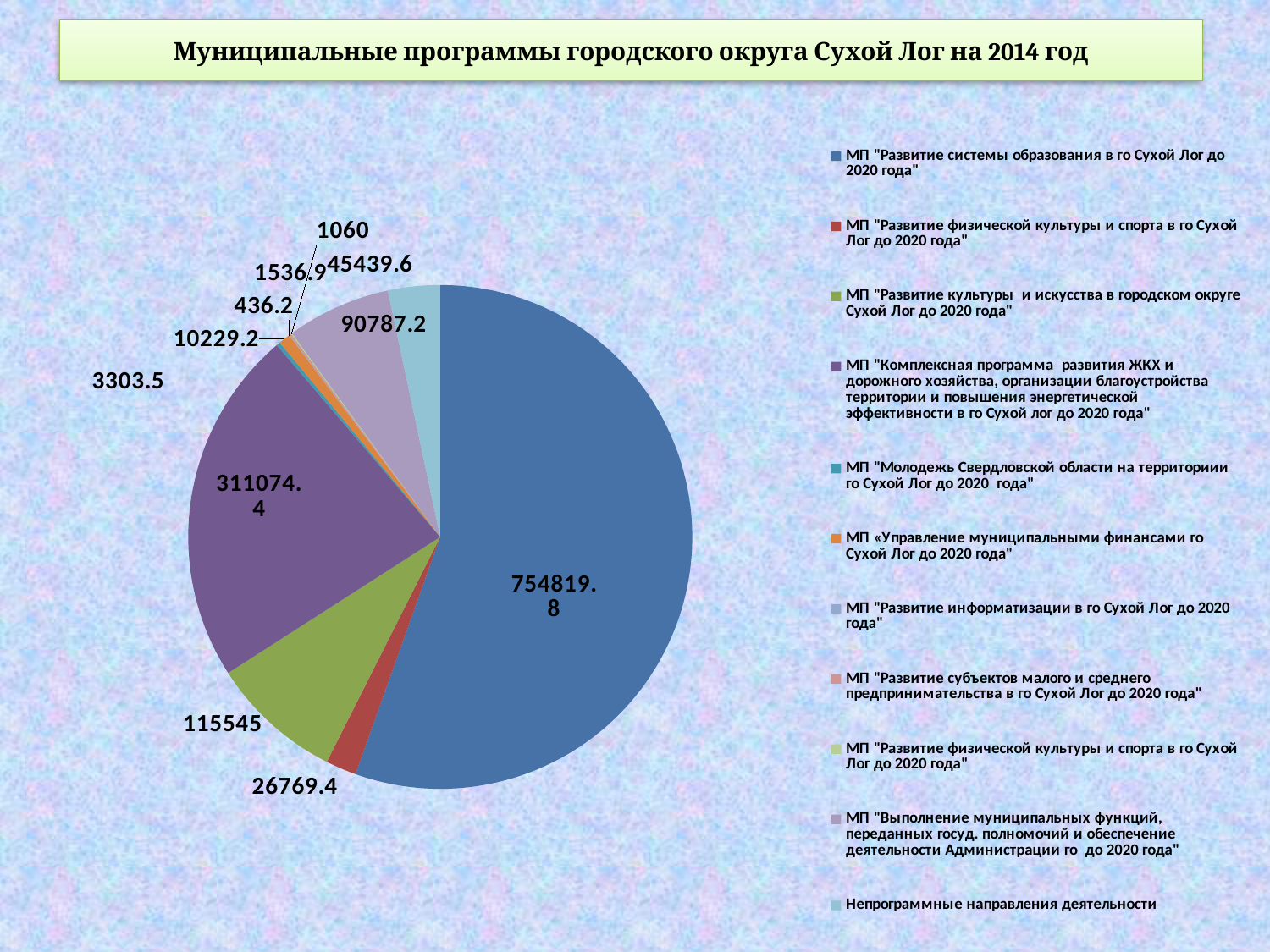
What is the value for МП "Развитие системы образования в го Сухой Лог до 2020 года"? 754819.8 What kind of chart is shown on the slide? pie chart Which is larger: the slice for МП "Развитие культуры и искусства..." or the slice for Непрограммные направления деятельности? МП "Развитие культуры и искусства в городском округе Сухой Лог до 2020 года" What is the value for Непрограммные направления деятельности? 45439.6 How many entries does the legend list? 11 What is the value for МП "Развитие культуры и искусства в городском округе Сухой Лог до 2020 года"? 115545 What is the difference between the value for the education program (754819.8) and the ЖКХ program (311074.4)? 443745.4 What is the smallest value labelled on the pie chart? 436.2 What is the value for МП "Комплексная программа развития ЖКХ и дорожного хозяйства..."? 311074.4 Which program has the largest slice of the pie? МП "Развитие системы образования в го Сухой Лог до 2020 года" What is the value for МП "Выполнение муниципальных функций, переданных госуд. полномочий и обеспечение деятельности Администрации го до 2020 года"? 90787.2 What is the title of the slide? Муниципальные программы городского округа Сухой Лог на 2014 год